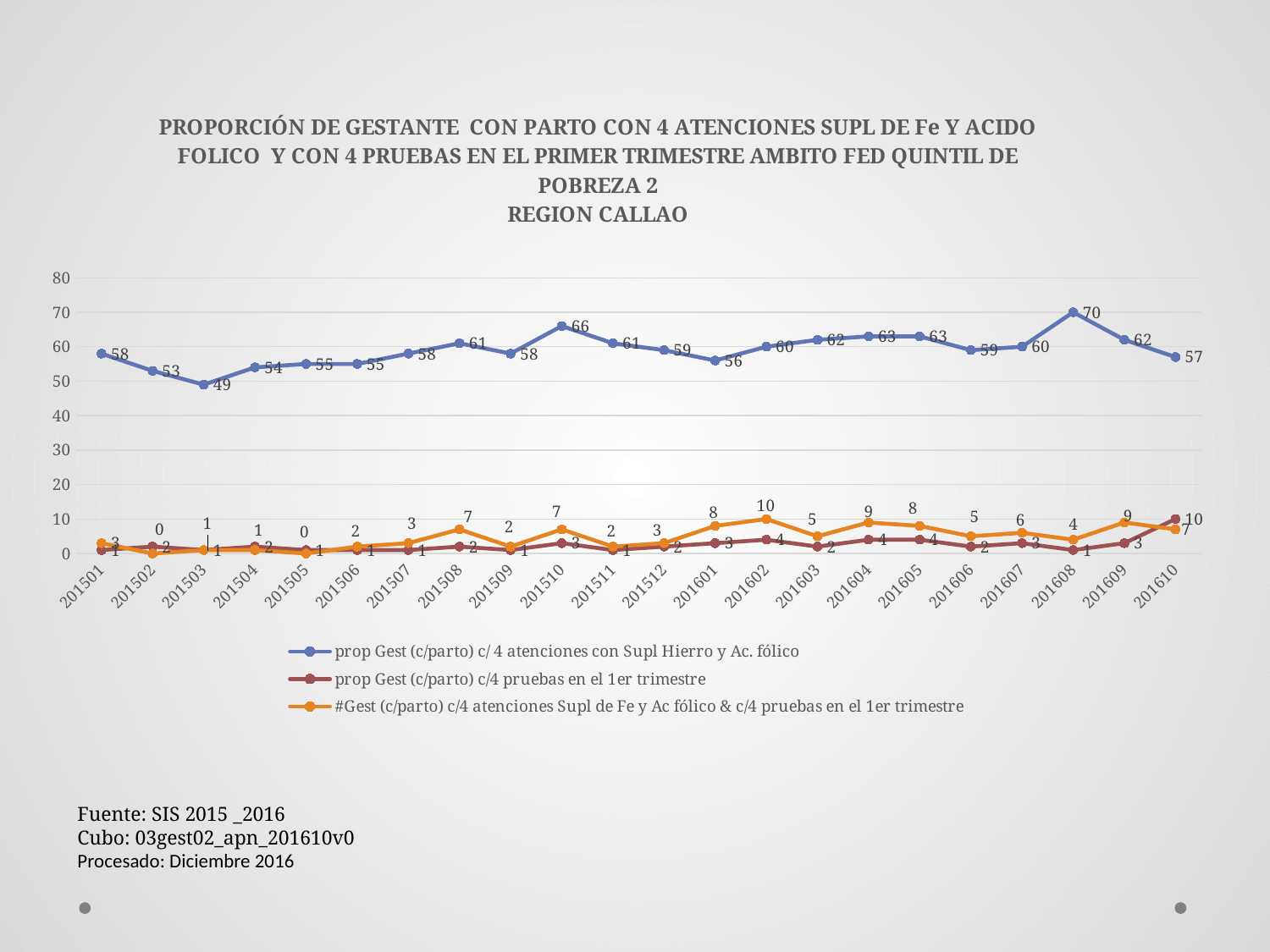
How many time points are plotted along the x axis? 22 What is the value of the 'prop Gest (c/parto) c/ 4 atenciones con Supl Hierro y Ac. fólico' series at 201510? 66 For the 'prop Gest (c/parto) c/ 4 atenciones con Supl Hierro y Ac. fólico' series, which is larger: the value at 201501 or the value at 201502? 201501 What is the value of the 'prop Gest (c/parto) c/ 4 atenciones con Supl Hierro y Ac. fólico' series at 201503? 49 What type of chart is shown on the slide? line chart What is the value of the '#Gest (c/parto) c/4 atenciones Supl de Fe y Ac fólico & c/4 pruebas en el 1er trimestre' series at 201602? 10 How many series does the legend list? 3 Is the value of the 'prop Gest (c/parto) c/ 4 atenciones con Supl Hierro y Ac. fólico' series at 201608 greater or less than 60? greater In which period does the 'prop Gest (c/parto) c/ 4 atenciones con Supl Hierro y Ac. fólico' series reach its lowest value? 201503 What is the difference between the 'prop Gest (c/parto) c/ 4 atenciones con Supl Hierro y Ac. fólico' values at 201608 and 201610? 13 In which period does the 'prop Gest (c/parto) c/ 4 atenciones con Supl Hierro y Ac. fólico' series reach its highest value? 201608 Which region is named in the chart title? REGION CALLAO